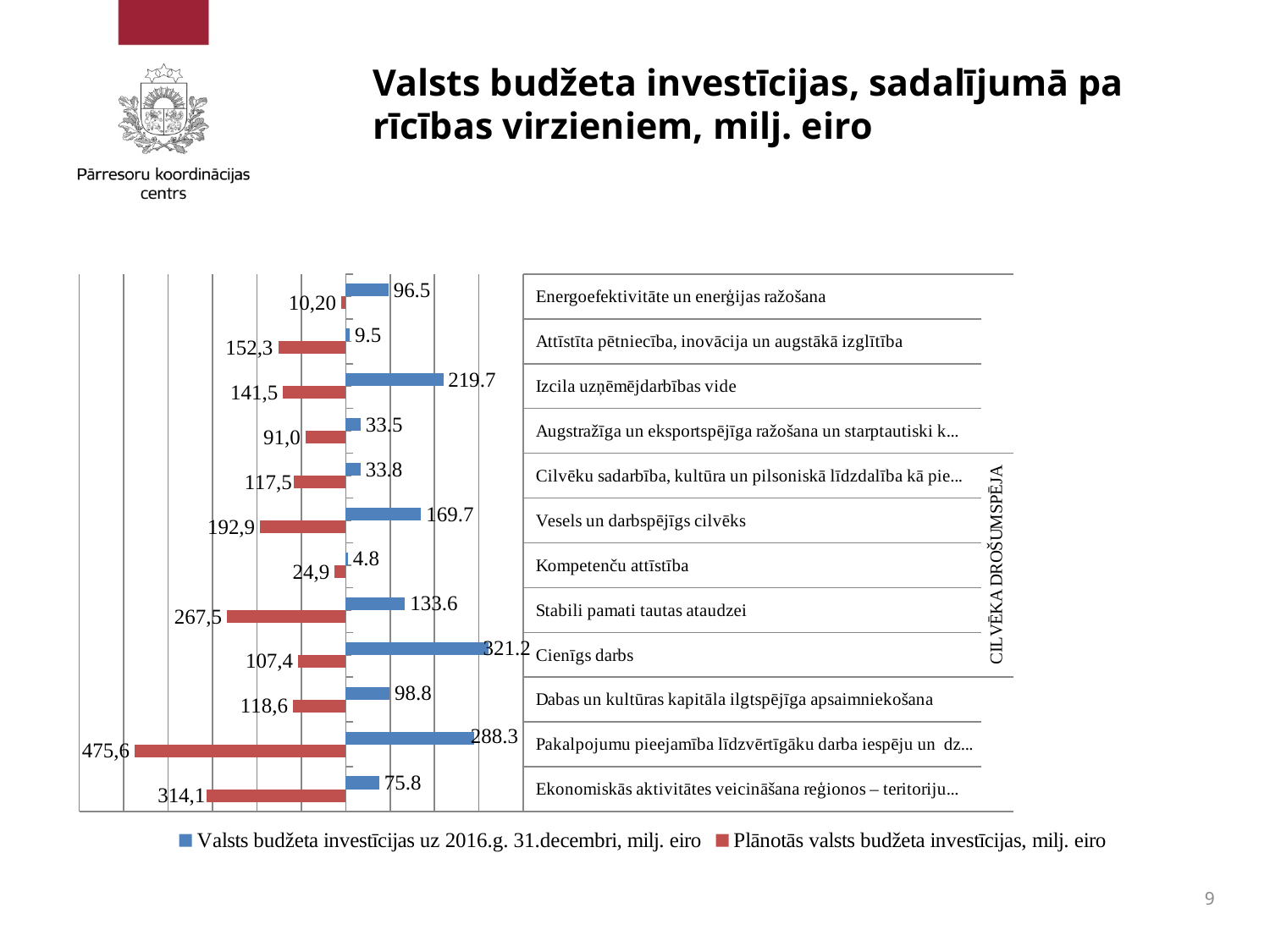
How many series does the legend list? 2 For Vesels un darbspējīgs cilvēks, what is the difference between the planned investments (192,9) and the investments as of 31 December 2016 (169.7)? 23.2 Which category has the lowest value for 'Valsts budžeta investīcijas uz 2016.g. 31.decembri, milj. eiro'? Kompetenču attīstība What is the value of 'Plānotās valsts budžeta investīcijas, milj. eiro' for Stabili pamati tautas ataudzei? 267,5 How many categories (action directions) are shown in the chart? 12 Which category has the highest value for 'Plānotās valsts budžeta investīcijas, milj. eiro'? Pakalpojumu pieejamība līdzvērtīgāku darba iespēju un dz... For Cienīgs darbs, which is larger: the investments as of 31 December 2016 or the planned investments? Valsts budžeta investīcijas uz 2016.g. 31.decembri, milj. eiro Which category has the highest value for 'Valsts budžeta investīcijas uz 2016.g. 31.decembri, milj. eiro'? Cienīgs darbs What is the value of 'Plānotās valsts budžeta investīcijas, milj. eiro' for Energoefektivitāte un enerģijas ražošana? 10,20 What is the value of 'Valsts budžeta investīcijas uz 2016.g. 31.decembri, milj. eiro' for Kompetenču attīstība? 4.8 What is the value of 'Valsts budžeta investīcijas uz 2016.g. 31.decembri, milj. eiro' for Izcila uzņēmējdarbības vide? 219.7 What kind of chart is shown on the slide? Bar chart